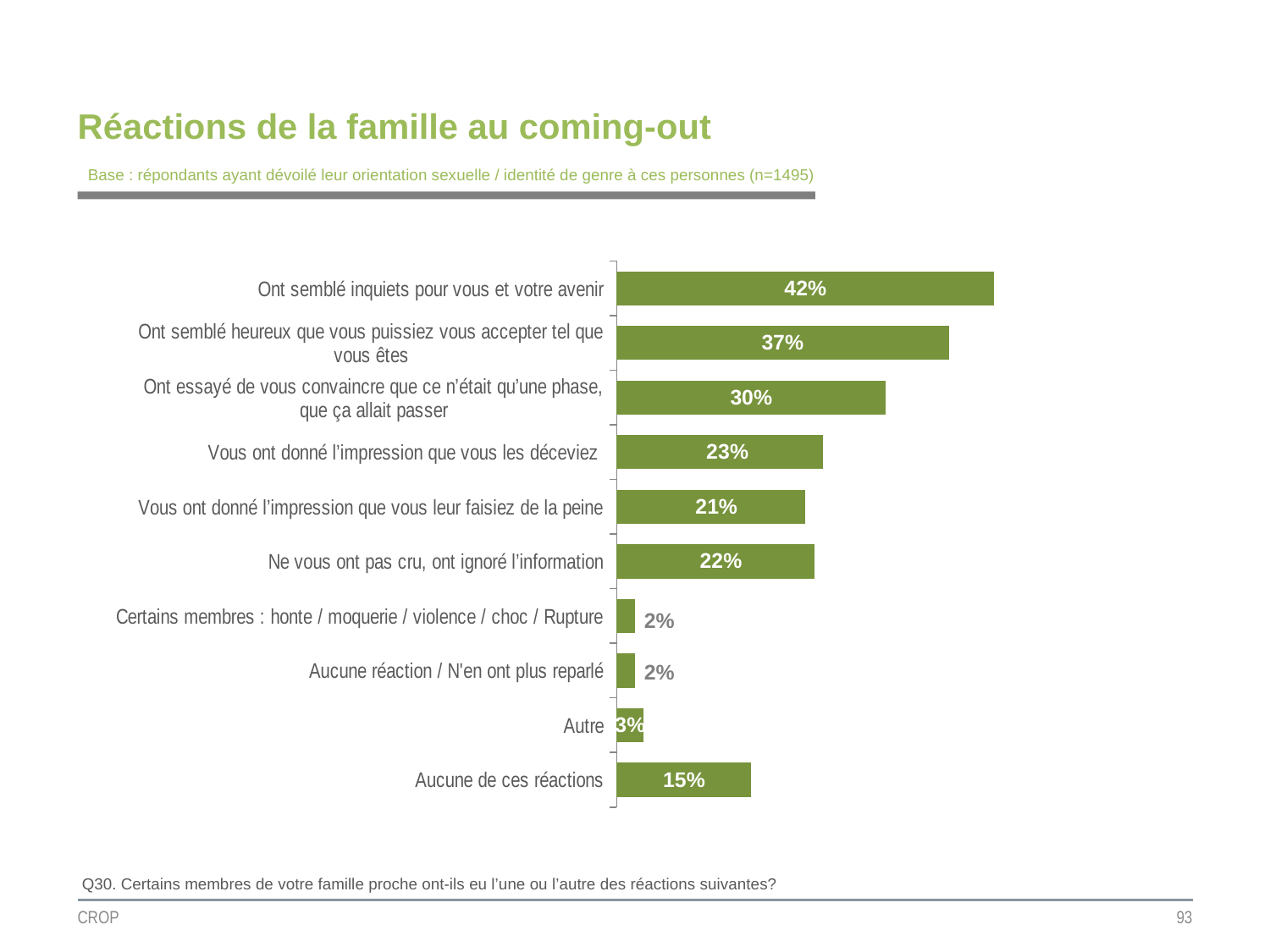
What value is shown for "Aucune de ces réactions"? 15% Which is larger: the value for "Vous ont donné l'impression que vous les déceviez" or the value for "Aucune de ces réactions"? Vous ont donné l'impression que vous les déceviez What value is shown for "Ont semblé inquiets pour vous et votre avenir"? 42% What is the difference between the values for "Ont semblé inquiets pour vous et votre avenir" and "Ont semblé heureux que vous puissiez vous accepter tel que vous êtes"? 5% What is the title of the chart on the slide? Réactions de la famille au coming-out What value is shown for "Ne vous ont pas cru, ont ignoré l'information"? 22% What is the difference between the values for "Ont essayé de vous convaincre que ce n'était qu'une phase, que ça allait passer" and "Aucune de ces réactions"? 15% What value is shown for "Ont essayé de vous convaincre que ce n'était qu'une phase, que ça allait passer"? 30% How many categories are shown in the chart? 10 What kind of chart is shown on the slide? Bar chart Which category has the highest value? Ont semblé inquiets pour vous et votre avenir What colour are the bars in the chart? Green